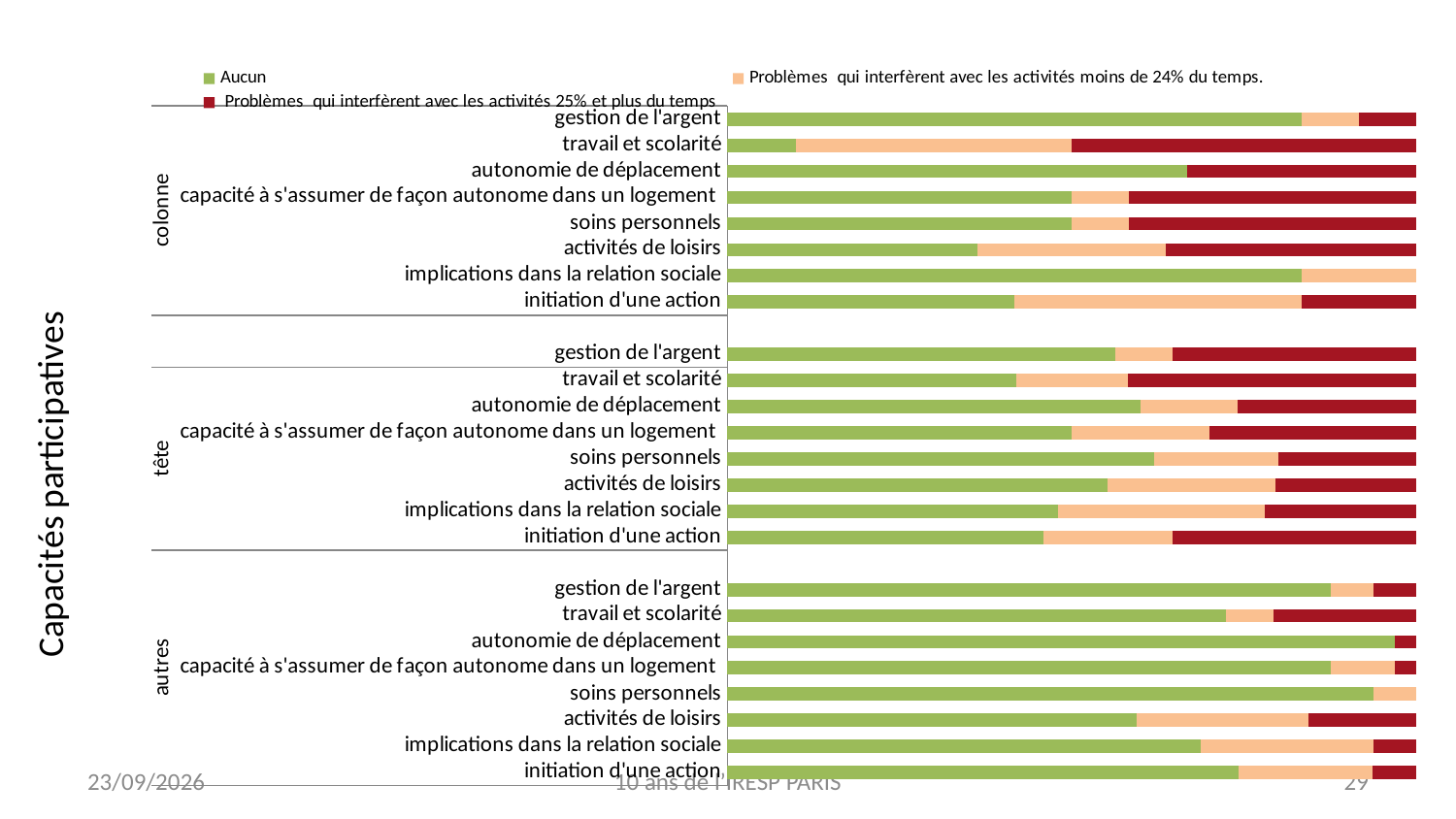
In the 'autres' group, is the 'Aucun' segment larger for 'soins personnels' or for 'activités de loisirs'? soins personnels In the 'colonne' group, which category has the smallest 'Aucun' segment? travail et scolarité In the 'colonne' group, is the 'Aucun' segment larger for 'gestion de l'argent' or for 'travail et scolarité'? gestion de l'argent How many groups of bars are shown on the chart? 3 In the 'colonne' group, which category has the largest 'Problèmes qui interfèrent avec les activités 25% et plus du temps' segment? travail et scolarité What are the names of the three groups on the vertical axis? colonne, tête, autres What kind of chart is shown on the slide? stacked bar chart How many series does the legend list? 3 In the 'tête' group, is the 'Problèmes qui interfèrent avec les activités 25% et plus du temps' segment larger for 'initiation d'une action' or for 'soins personnels'? initiation d'une action In the 'autres' group, which category has the largest 'Aucun' segment? autonomie de déplacement Which series is shown in green in the legend? Aucun How many categories are plotted within the 'colonne' group? 8